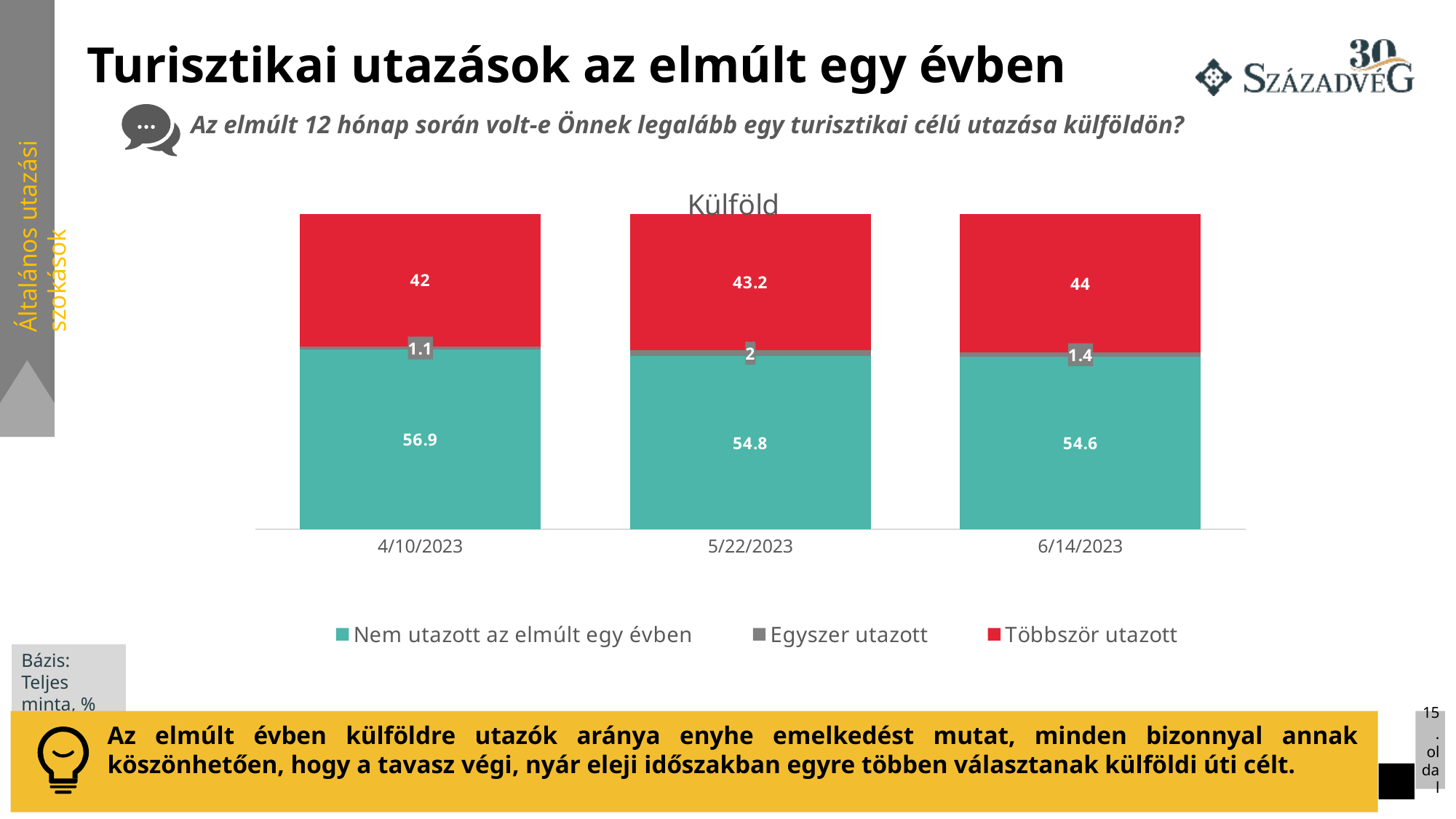
What is the difference between the "Többször utazott" values on 6/14/2023 and 4/10/2023? 2 What kind of chart is shown on the slide? Stacked bar chart On which date is the "Többször utazott" value highest? 6/14/2023 On which date is the "Nem utazott az elmúlt egy évben" value lowest? 6/14/2023 What is the value for "Nem utazott az elmúlt egy évben" on 4/10/2023? 56.9 What is the value for "Többször utazott" on 6/14/2023? 44 How many series does the legend list? 3 Does the "Többször utazott" value rise or fall across the dates from 4/10/2023 to 6/14/2023? Rise What is the value for "Egyszer utazott" on 5/22/2023? 2 What is the total of the stacked bar for 5/22/2023? 100 Which is larger: the "Egyszer utazott" value on 5/22/2023 or on 6/14/2023? 5/22/2023 How many dates are shown on the x axis? 3